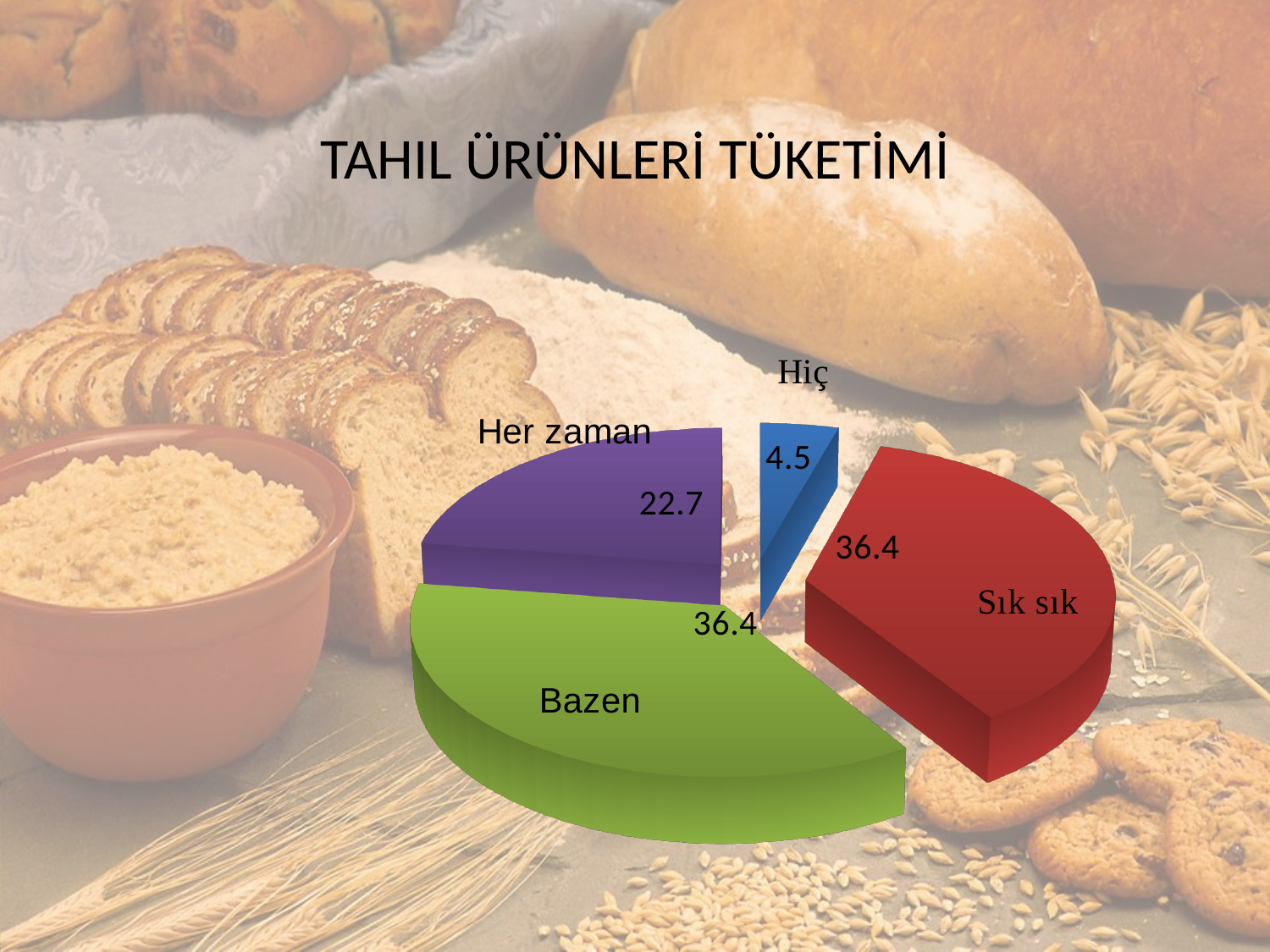
What is the difference between the values for "Sık sık" and "Her zaman"? 13.7 What is the title of the chart? TAHIL ÜRÜNLERİ TÜKETİMİ How many slices does the pie chart have? 4 What is the value for the "Hiç" slice? 4.5 What type of chart is shown on the slide? pie chart What is the difference between the values for "Her zaman" and "Hiç"? 18.2 Which category has the smallest slice? Hiç What is the value for the "Bazen" slice? 36.4 What is the value for the "Her zaman" slice? 22.7 Which is larger, the value for "Bazen" or the value for "Her zaman"? Bazen Which is larger, the value for "Her zaman" or the value for "Hiç"? Her zaman What is the value for the "Sık sık" slice? 36.4